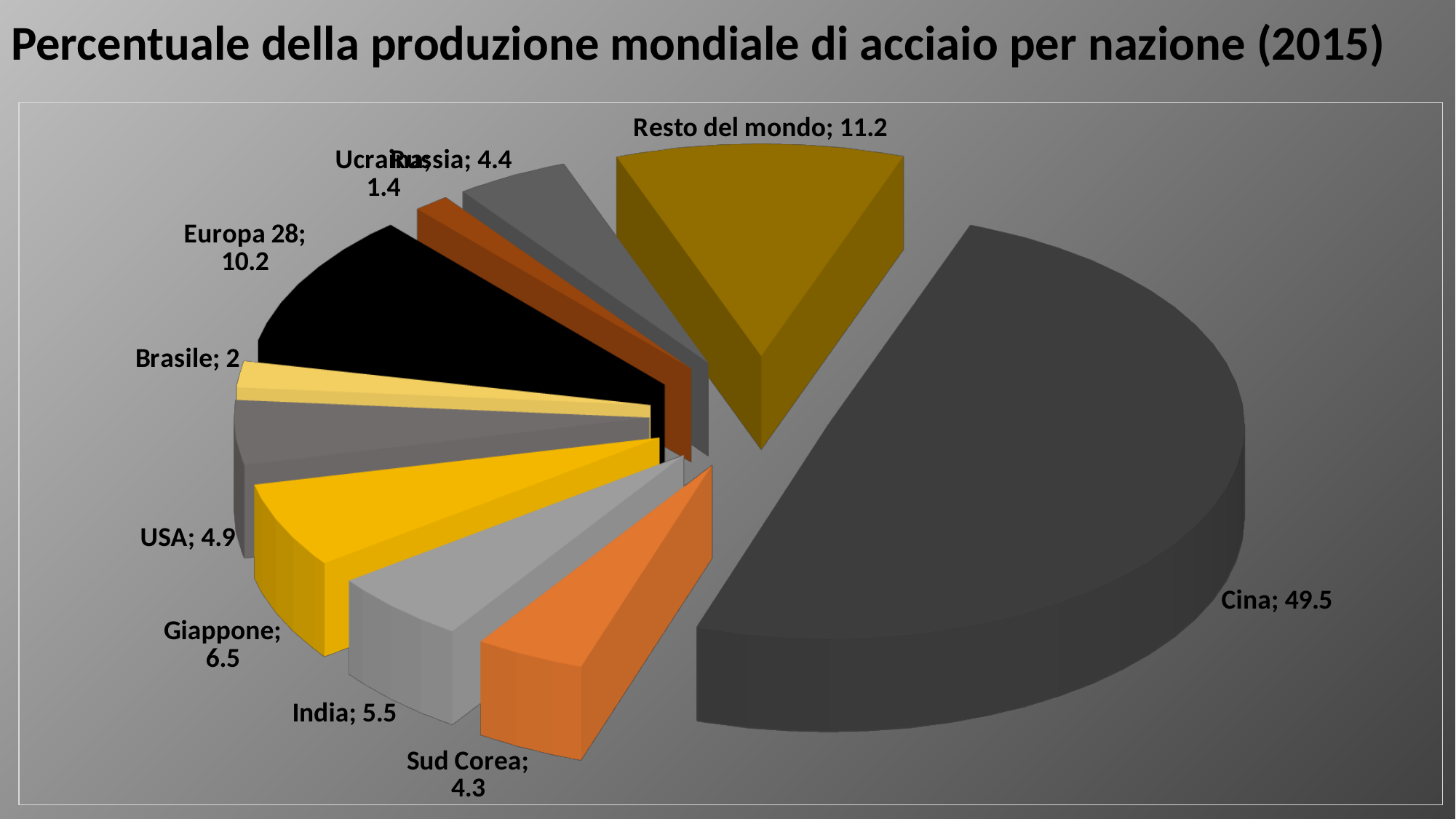
What is the value shown for Europa 28? 10.2 How many slices does the pie chart have? 10 What type of chart is shown on the slide? Pie chart Which is larger, the value for Giappone or the value for India? Giappone What is the difference between the values for India and Sud Corea? 1.2 What is the value shown for Giappone? 6.5 What is the value shown for Resto del mondo? 11.2 What percentage of world steel production does Cina account for? 49.5 Which country has the largest slice of the pie? Cina Which is larger, the value for USA or the value for Russia? USA Which category has the smallest slice of the pie? Ucraina What is the difference between the values for Resto del mondo and Europa 28? 1